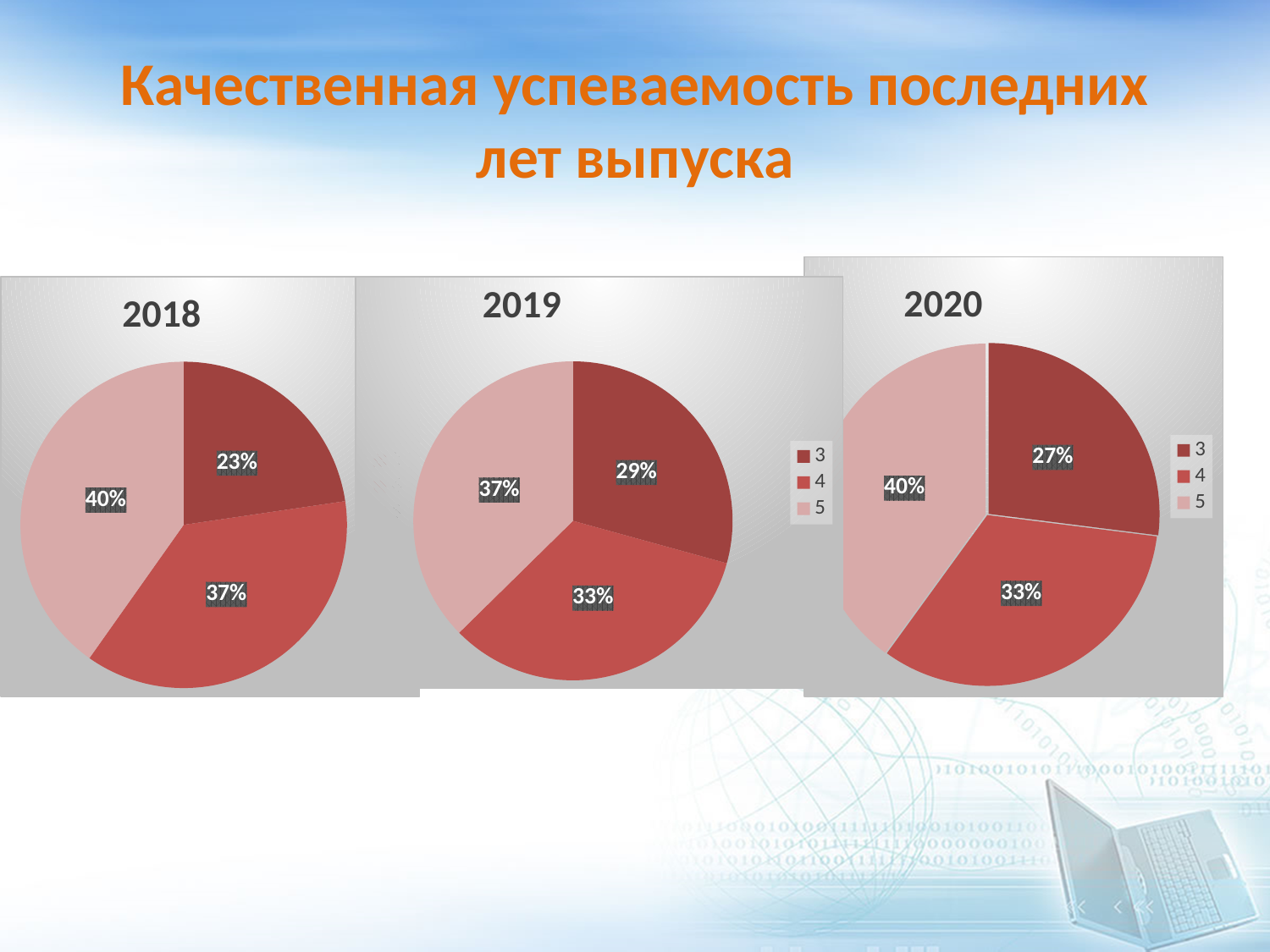
In the 2018 pie chart, what share is shown for grade 3? 23% In the 2018 pie chart, what is the difference between the shares for grade 5 and grade 3? 17% In the 2019 pie chart, what is the difference between the shares for grade 5 and grade 3? 8% How many entries does the legend of the 2020 chart list? 3 In the 2020 pie chart, which grade has the smallest slice? 3 How many slices does the 2020 pie chart have? 3 What type of chart is used for the 2018 data? Pie chart Which is larger: the share for grade 3 in 2019 or the share for grade 3 in 2020? 2019 In the 2019 pie chart, which grade has the largest slice? 5 In the 2018 pie chart, what share is shown for grade 5? 40% In the 2019 pie chart, what share is shown for grade 4? 33% In the 2020 pie chart, what share is shown for grade 3? 27%